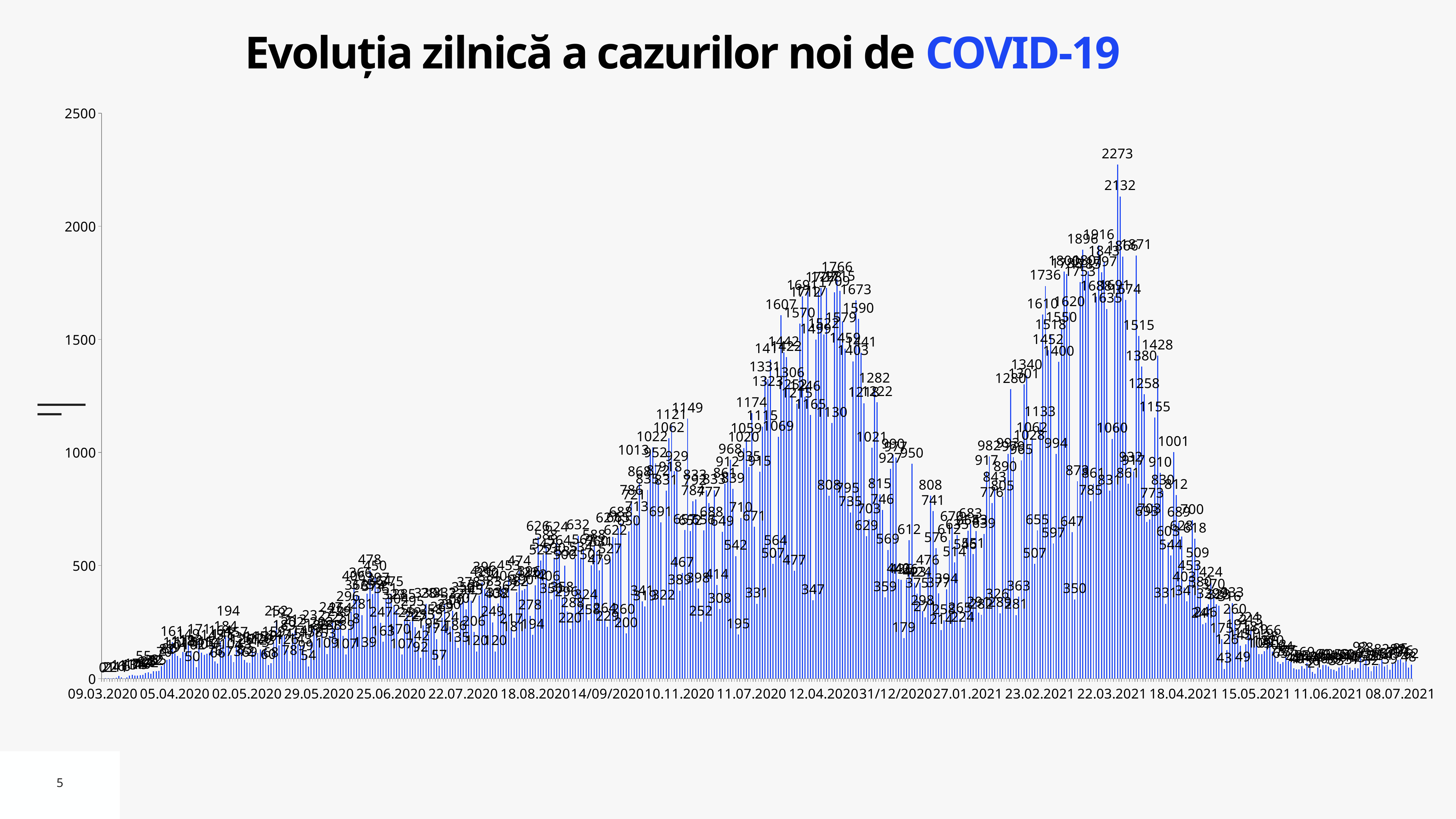
What is the difference between the two highest labeled values, 2273 and 2132? 141 What is the second-highest value labeled on the chart, next to the 2273 peak? 2132 Do the values rise or fall from the peak around 22.03.2021 to the end of the chart at 08.07.2021? fall What is the first date shown on the x axis? 09.03.2020 What kind of chart is shown on the slide? bar chart How many date labels are shown on the x axis? 19 What is the highest daily value labeled on the chart? 2273 Which peak is higher: the one around 22.03.2021 or the one around 10.11.2020? 22.03.2021 Is the highest bar on the chart greater or less than 2000? greater Are the bars at the far right of the chart, around 08.07.2021, greater or less than 500? less What is the highest tick value on the y axis? 2500 What is the highest labeled value in the wave around November–December 2020? 1766